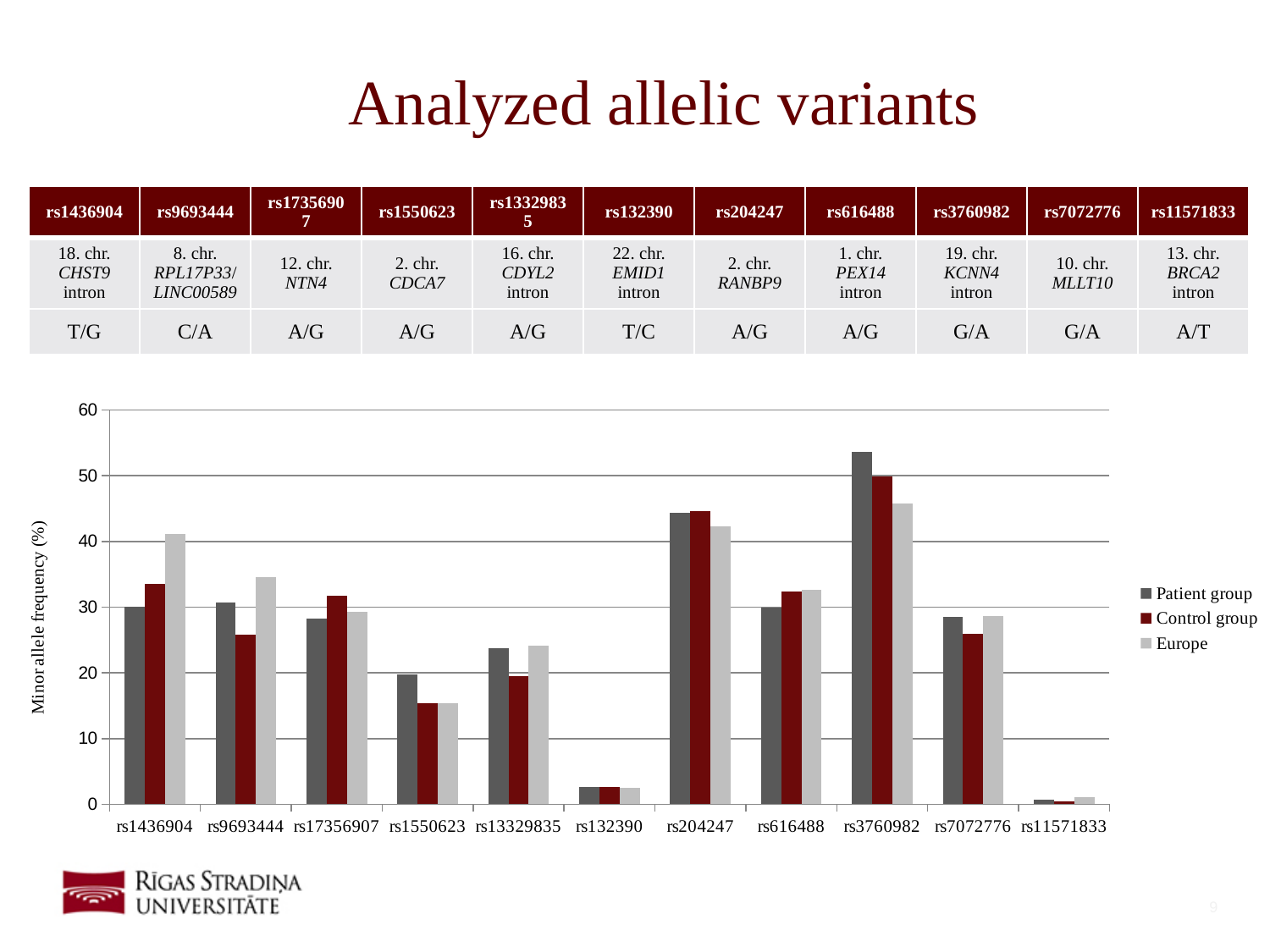
Is the Europe value for rs1436904 greater or less than 40? greater For rs9693444, which is larger: the Patient group value or the Control group value? Patient group How many allelic variants (categories) are plotted along the x axis of the chart? 11 How many series does the chart's legend list? 3 Is the Control group value for rs1550623 greater or less than 20? less Is the Patient group value for rs3760982 greater or less than 50? greater For which variant is the Patient group bar the highest? rs3760982 Which series is shown in dark red in the chart's legend? Control group What kind of chart is shown on the slide? bar chart For which variant is the Patient group bar the lowest? rs11571833 For rs1436904, which is larger: the Patient group value or the Europe value? Europe What is the label of the chart's y axis? Minor allele frequency (%)